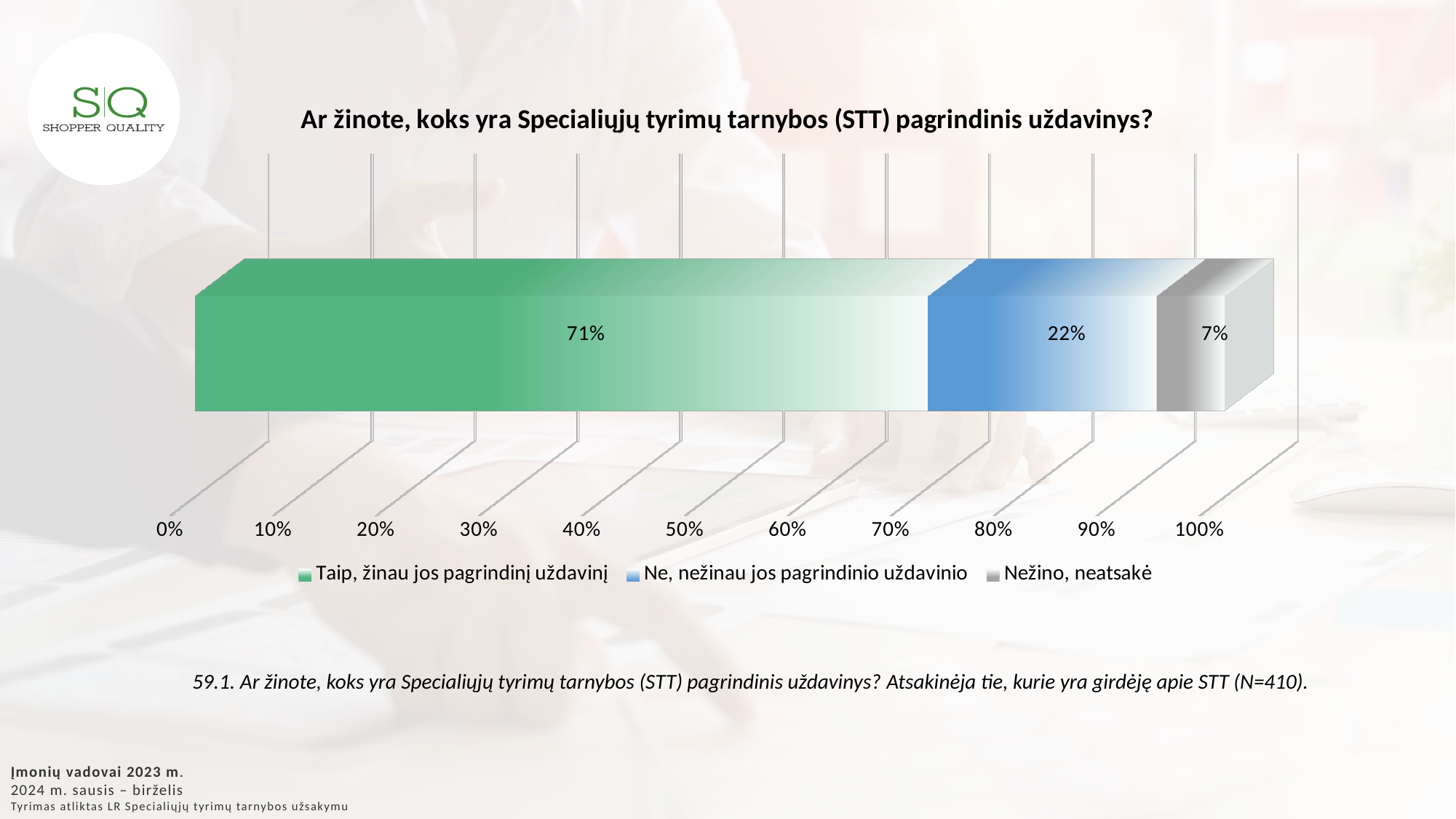
How many series does the legend list? 3 Which is larger: the share for "Ne, nežinau jos pagrindinio uždavinio" or for "Nežino, neatsakė"? Ne, nežinau jos pagrindinio uždavinio What percentage of respondents answered "Nežino, neatsakė"? 7% What colour is the segment for "Ne, nežinau jos pagrindinio uždavinio"? Blue Which response category has the largest share? Taip, žinau jos pagrindinį uždavinį What percentage of respondents answered "Taip, žinau jos pagrindinį uždavinį"? 71% Which response category has the smallest share? Nežino, neatsakė What is the total of the three segments in the stacked bar? 100% What is the difference in percentage points between "Taip, žinau jos pagrindinį uždavinį" and "Ne, nežinau jos pagrindinio uždavinio"? 49 percentage points What percentage of respondents answered "Ne, nežinau jos pagrindinio uždavinio"? 22% Is the value for "Taip, žinau jos pagrindinį uždavinį" greater or less than 50%? greater What kind of chart is shown on the slide? Stacked bar chart